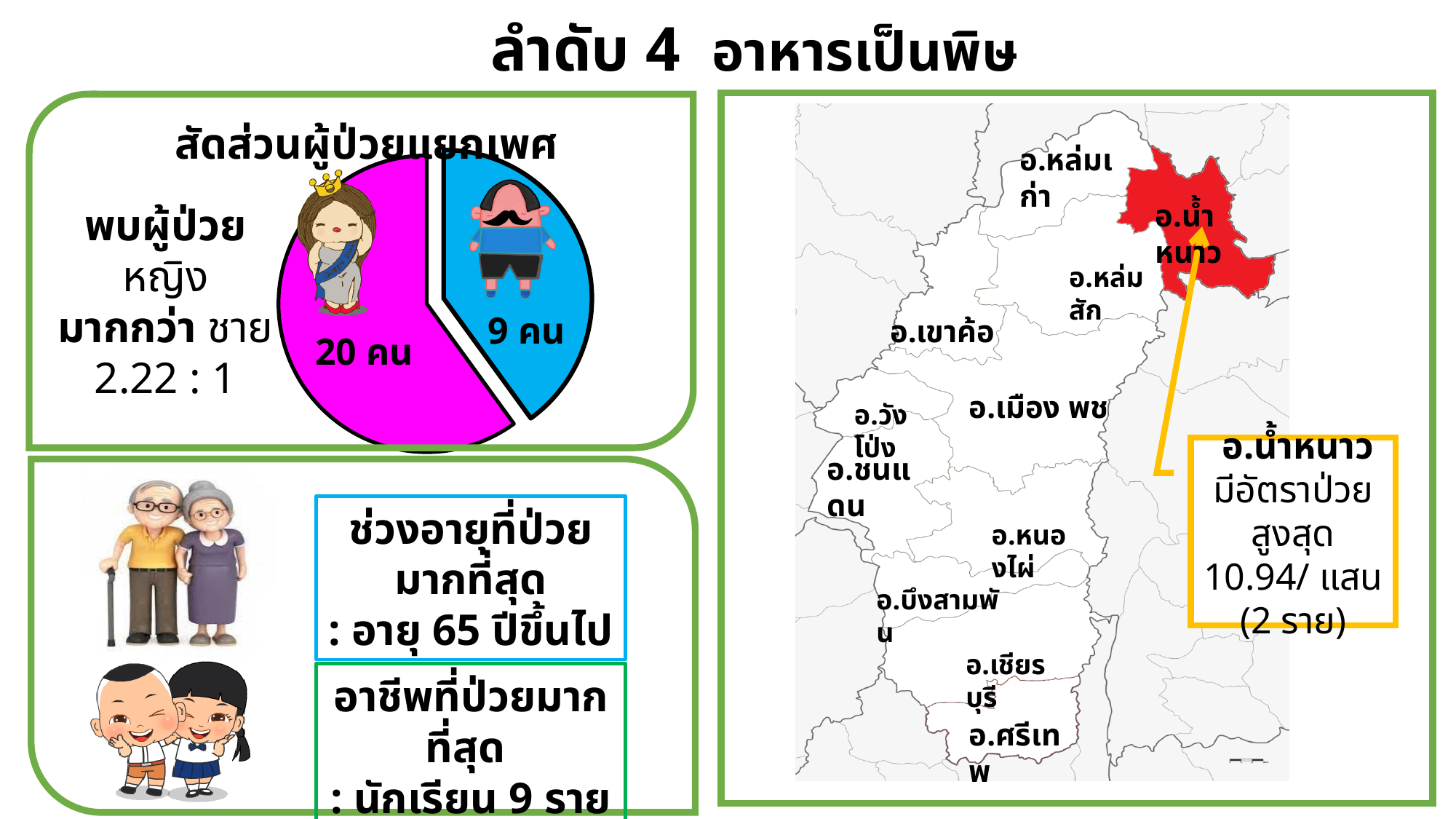
What female-to-male ratio of patients is stated next to the pie chart? 2.22 : 1 What colour is the slice for female patients (20 คน)? magenta (pink) Which group has the smaller slice in the pie chart? male (ชาย) How many slices does the pie chart have? 2 What kind of chart is shown on the slide? pie chart What is the title of the pie chart? สัดส่วนผู้ป่วยแยกเพศ What is the total number of patients shown in the pie chart? 29 คน Which group has the larger slice in the pie chart, female or male? female (หญิง) What is the difference between the number of female and male patients in the pie chart? 11 คน How many patients are female (หญิง) in the pie chart? 20 คน How many patients are male (ชาย) in the pie chart? 9 คน Is the number of female patients greater or less than the number of male patients? greater